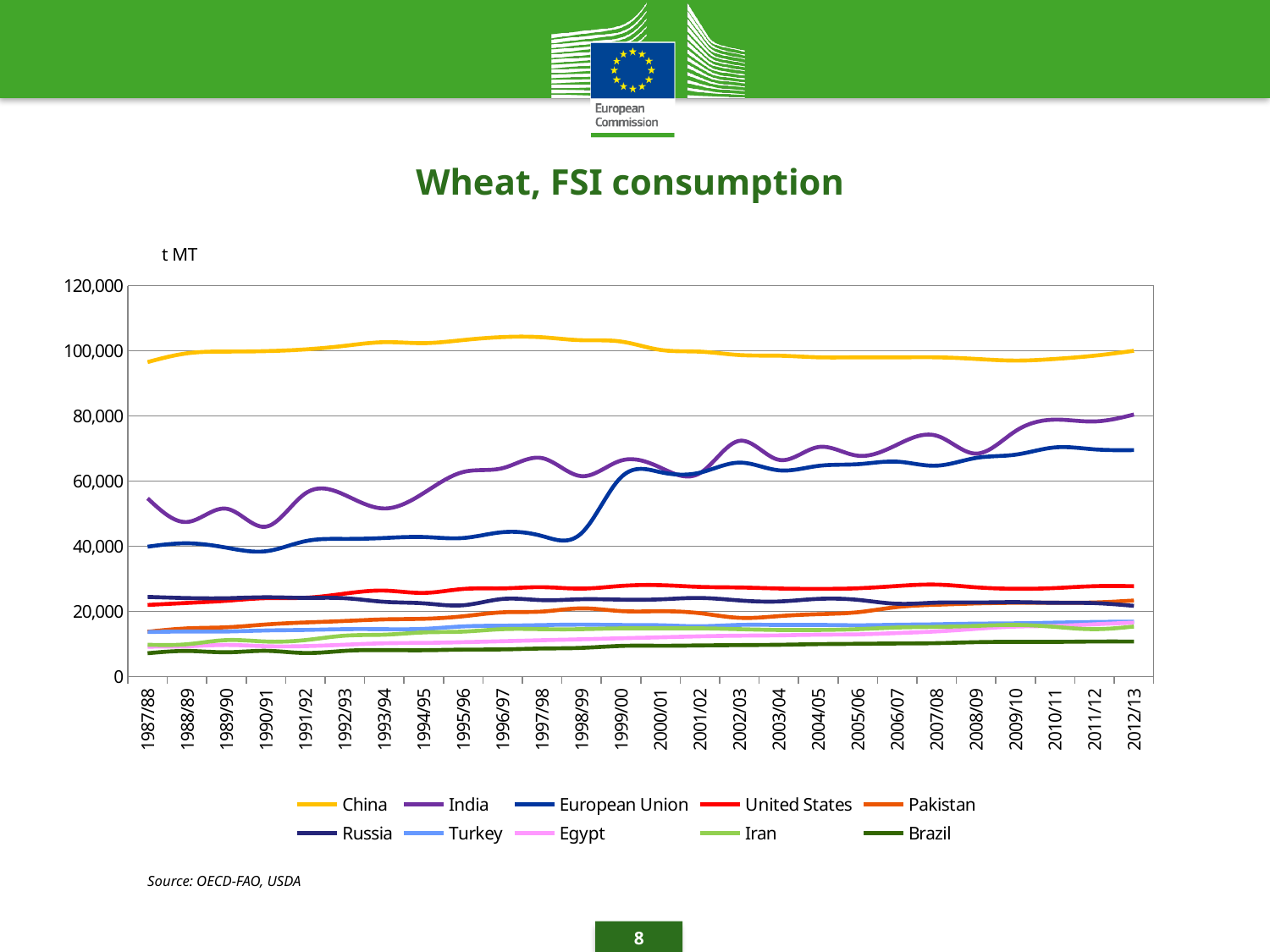
Which country has the lowest wheat FSI consumption in 2012/13? Brazil In 1987/88, which is larger: the value for India or the European Union? India Is the value for the European Union in 1987/88 greater or less than 60,000? less How many marketing years are shown on the x axis? 26 What unit is shown above the y axis? t MT Is the value for China in 1987/88 greater or less than 80,000? greater What kind of chart is shown on the slide? line chart Is the value for the United States in 2012/13 greater or less than 20,000? greater In 2012/13, which is larger: the value for the European Union or the United States? European Union Does the value for India generally rise or fall from 1987/88 to 2012/13? rise Which country has the highest wheat FSI consumption across the whole period? China How many series does the legend list? 10